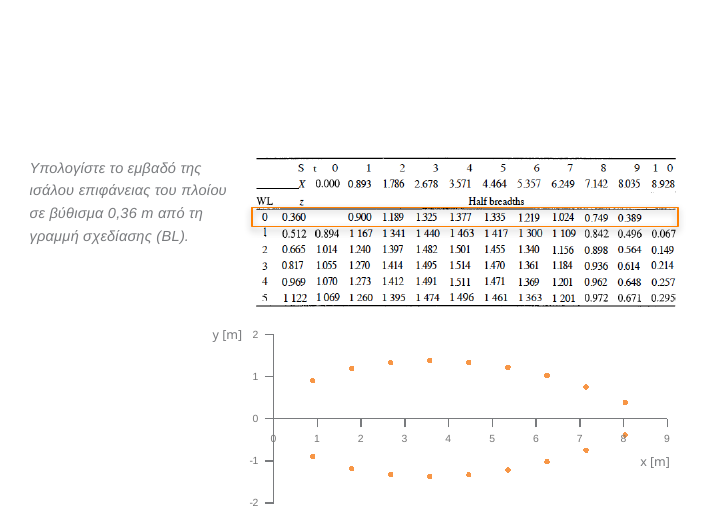
What is the label of the vertical axis of the chart? y [m] Is the y value of the upper point near x = 8 greater or less than 1? less How many data points are plotted on the chart? 18 Is the y value of the lower point near x = 4 greater or less than -1? less Is the y value of the upper point near x = 4 greater or less than 1? greater What is the label of the horizontal axis of the chart? x [m] What kind of chart is shown on the slide? scatter chart Which upper point has the larger y value, the one near x = 2 or the one near x = 8? the one near x = 2 Do the y values of the upper points rise or fall as x increases from about 1 to about 4? rise Do the y values of the upper points rise or fall as x increases from about 4 to about 8? fall